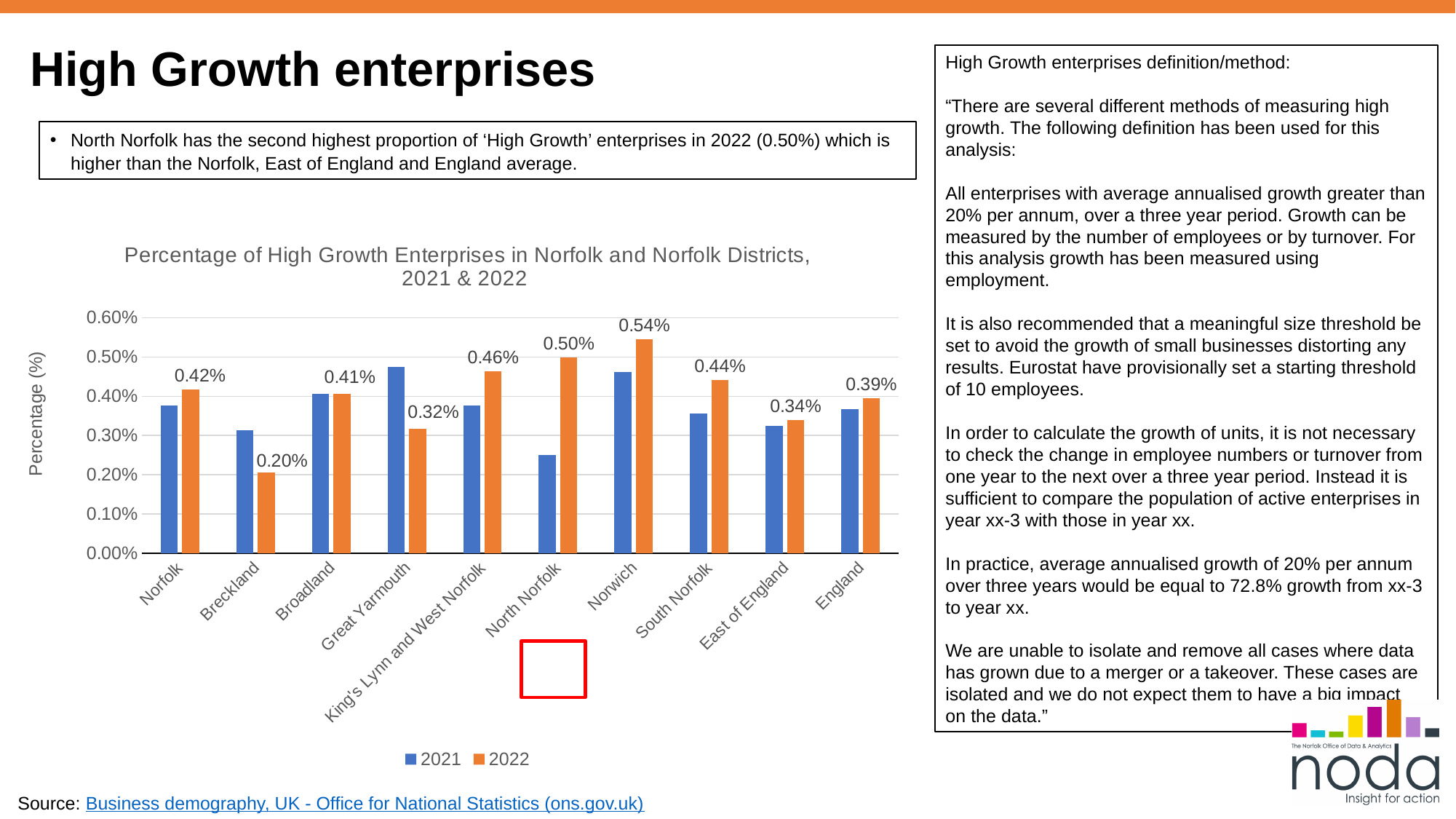
Which area has the lowest 2022 value? Breckland What kind of chart is shown? bar chart What is the 2022 value for North Norfolk? 0.50% Is the 2021 value for North Norfolk greater or less than 0.30%? less How many areas are shown on the x axis? 10 What is the 2022 value for King's Lynn and West Norfolk? 0.46% Which area has the highest 2022 value? Norwich What is the 2022 value for Breckland? 0.20% Is the 2021 value for Great Yarmouth greater or less than 0.40%? greater What is the difference between the 2022 values for Norwich and North Norfolk? 0.04% How many series does the legend list? 2 Which is larger for Great Yarmouth, the 2021 bar or the 2022 bar? 2021